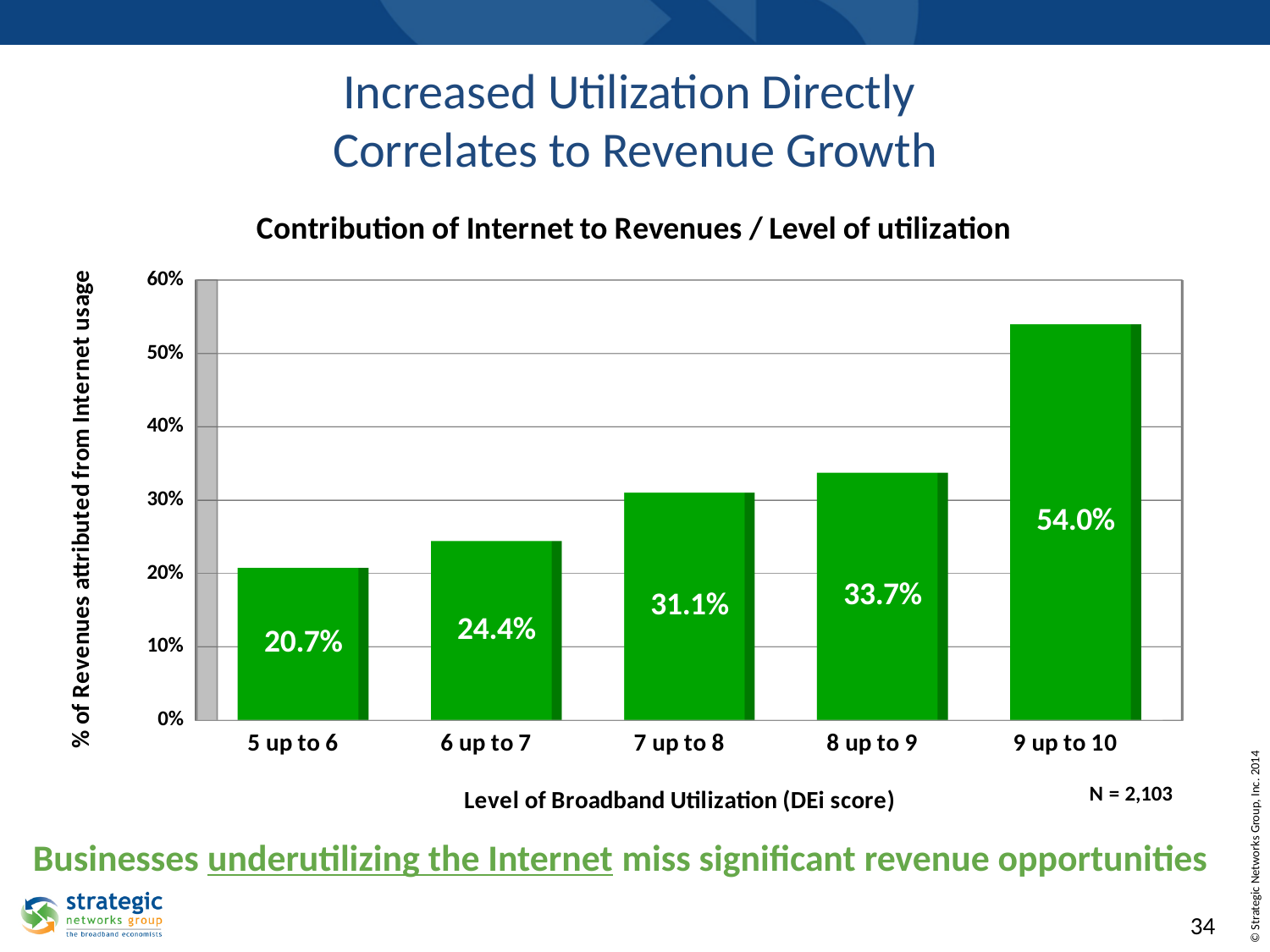
What is the difference between the values for "9 up to 10" and "8 up to 9"? 20.3% Which category has the highest value? 9 up to 10 Do the values rise or fall as the level of broadband utilization increases along the x axis? rise What is the value for the "9 up to 10" category? 54.0% What is the value for the "5 up to 6" category? 20.7% Which category has the lowest value? 5 up to 6 What kind of chart is shown on the slide? bar chart How many categories are shown on the x axis? 5 Which is larger, the value for "7 up to 8" or the value for "8 up to 9"? 8 up to 9 What is the difference between the values for "6 up to 7" and "5 up to 6"? 3.7% What is the value for the "7 up to 8" category? 31.1% Is the value for "9 up to 10" greater or less than 50%? greater